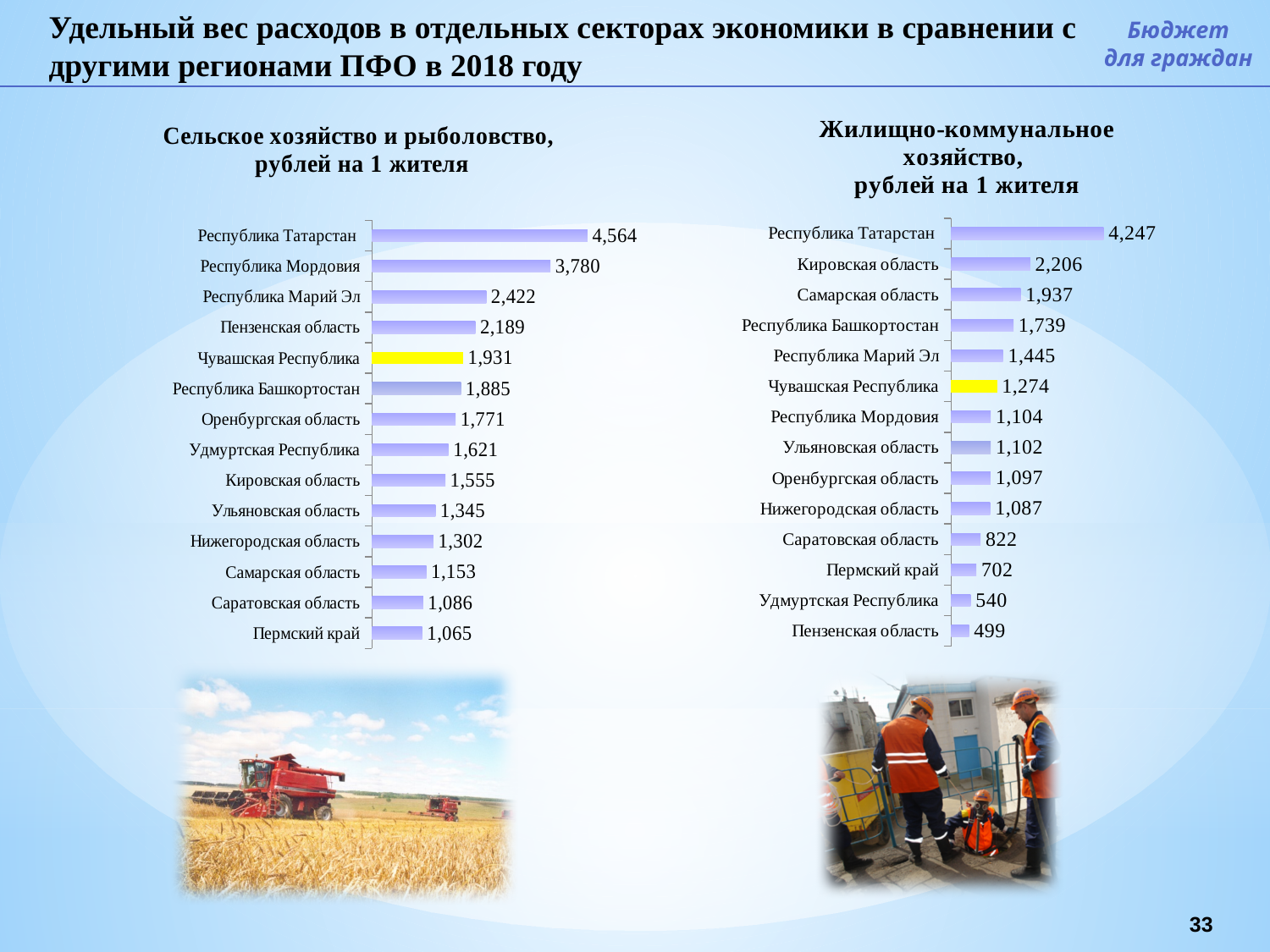
On the right chart (Жилищно-коммунальное хозяйство), what is the difference between Кировская область and Самарская область? 269 On the left chart (Сельское хозяйство и рыболовство), which region's bar is highlighted in yellow? Чувашская Республика How many regions are shown on the left chart (Сельское хозяйство и рыболовство)? 14 What type of chart is used on the right (Жилищно-коммунальное хозяйство)? Bar chart On the right chart (Жилищно-коммунальное хозяйство), which is larger: Саратовская область or Пермский край? Саратовская область On the right chart (Жилищно-коммунальное хозяйство), which region has the highest value? Республика Татарстан On the left chart (Сельское хозяйство и рыболовство), what is the difference between Республика Татарстан and Республика Мордовия? 784 On the left chart (Сельское хозяйство и рыболовство), what is the value for Республика Татарстан? 4,564 On the left chart (Сельское хозяйство и рыболовство), which is larger: Пензенская область or Чувашская Республика? Пензенская область On the right chart (Жилищно-коммунальное хозяйство), which region has the lowest value? Пензенская область On the left chart (Сельское хозяйство и рыболовство), which region has the lowest value? Пермский край On the right chart (Жилищно-коммунальное хозяйство), what is the value for Чувашская Республика? 1,274